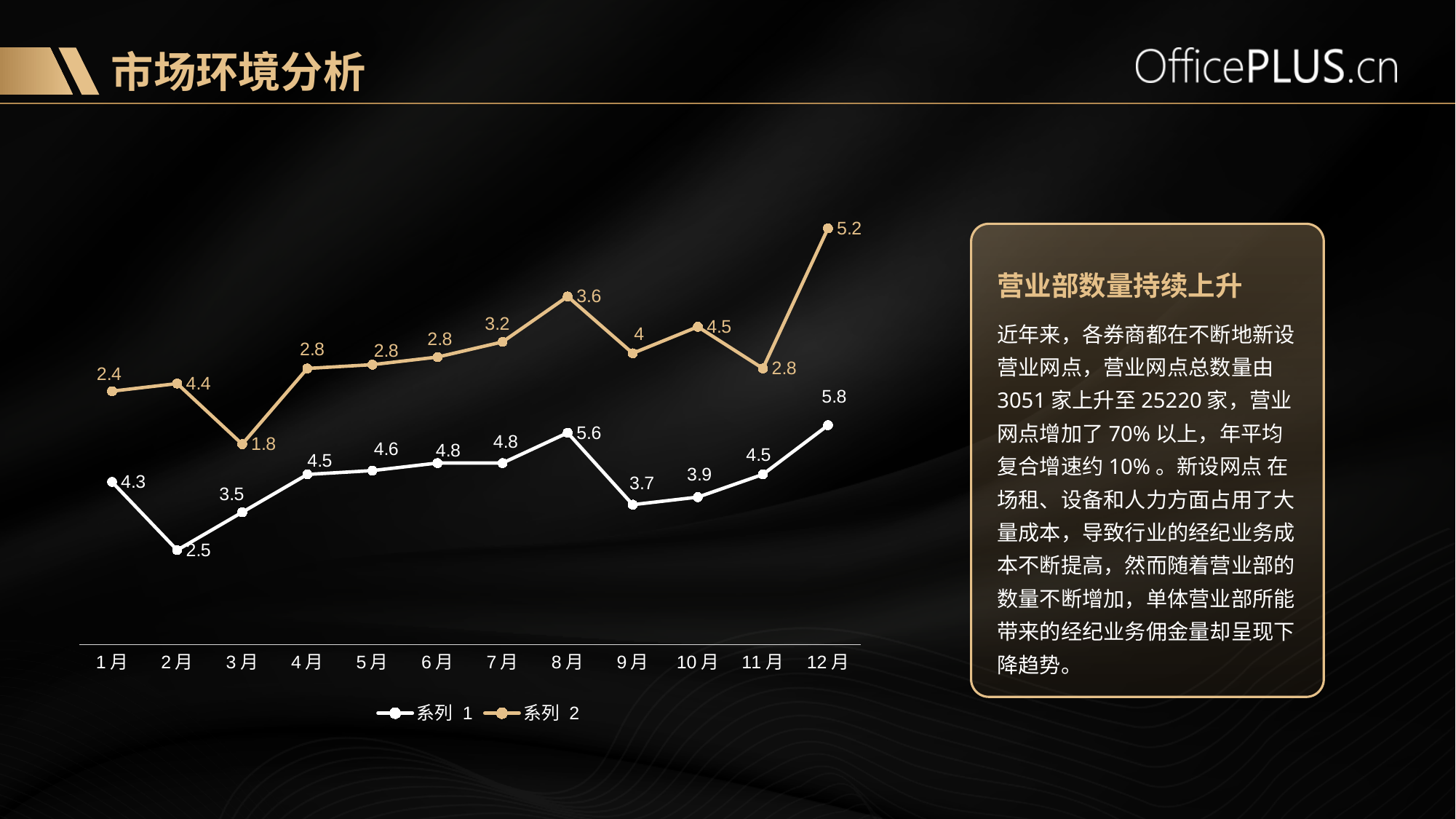
In which month does 系列 1 reach its highest value? 12月 How many series does the legend list? 2 Which series has the larger value in 1月, 系列 1 or 系列 2? 系列 1 What is the value of 系列 2 in 3月? 1.8 What is the value of 系列 1 in 8月? 5.6 Does 系列 1 rise or fall from 9月 to 12月? Rise In which month does 系列 1 have its lowest value? 2月 In which month does 系列 2 have its lowest value? 3月 What is the value of 系列 2 in 12月? 5.2 What kind of chart is shown on the slide? Line chart What is the difference between the highest and lowest values of 系列 1? 3.3 How many months are shown on the x axis? 12